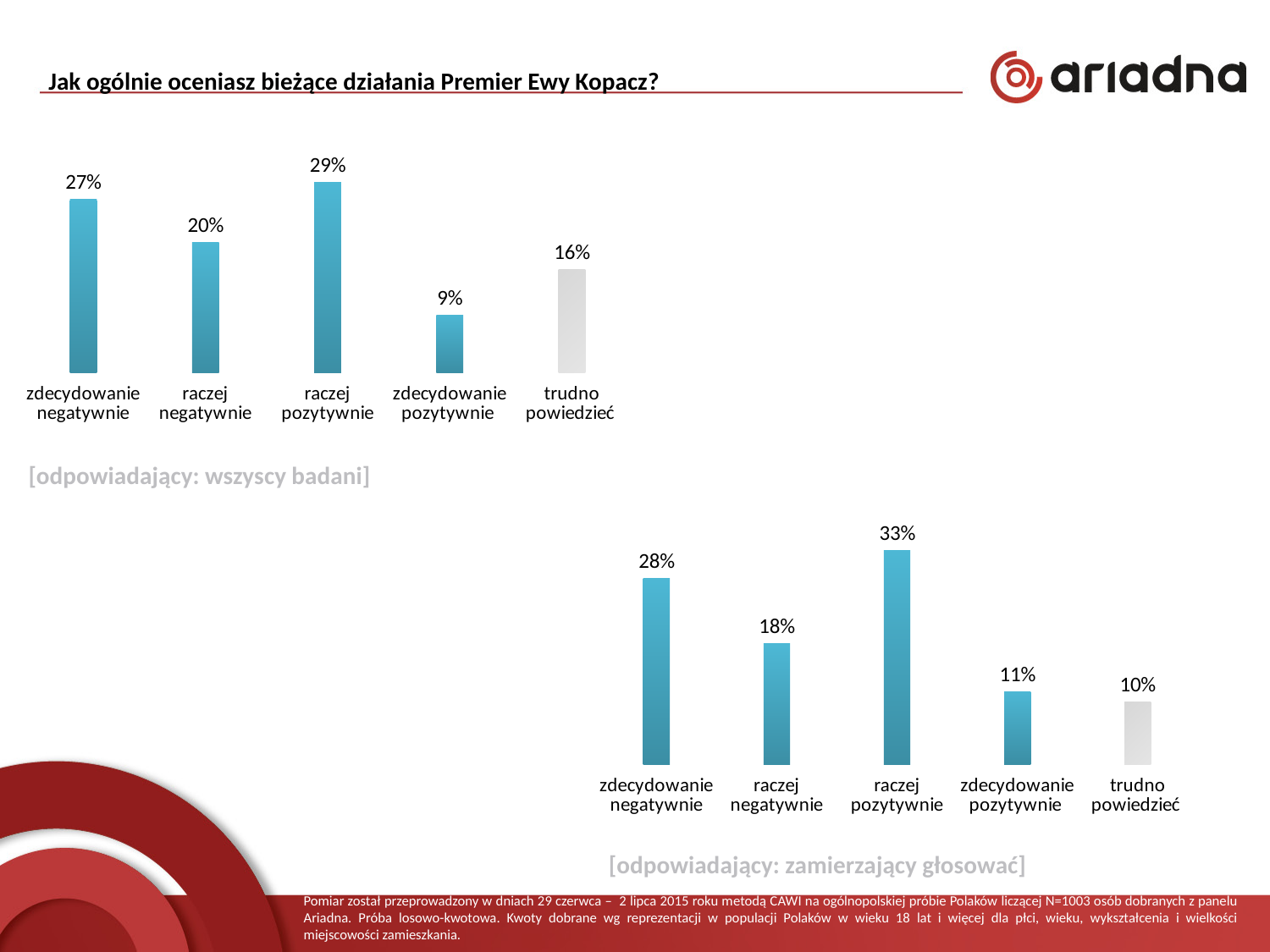
In the bottom chart (zamierzający głosować), what is the difference between 'raczej pozytywnie' and 'raczej negatywnie'? 15% In the top chart (wszyscy badani), which category has the lowest value? zdecydowanie pozytywnie What type of chart is the bottom chart (zamierzający głosować)? bar chart In the top chart (wszyscy badani), what is the difference between 'zdecydowanie negatywnie' and 'raczej negatywnie'? 7% How many categories does the top chart (wszyscy badani) show? 5 In the bottom chart (zamierzający głosować), what is the value for 'zdecydowanie negatywnie'? 28% In the top chart (wszyscy badani), what is the value for 'raczej pozytywnie'? 29% In the bottom chart (zamierzający głosować), what is the value for 'zdecydowanie pozytywnie'? 11% In the bottom chart (zamierzający głosować), which category has the highest value? raczej pozytywnie In the bottom chart (zamierzający głosować), which is larger: 'raczej negatywnie' or 'trudno powiedzieć'? raczej negatywnie In the top chart (wszyscy badani), what is the value for 'trudno powiedzieć'? 16% In the top chart (wszyscy badani), which bar is shown in grey rather than blue? trudno powiedzieć